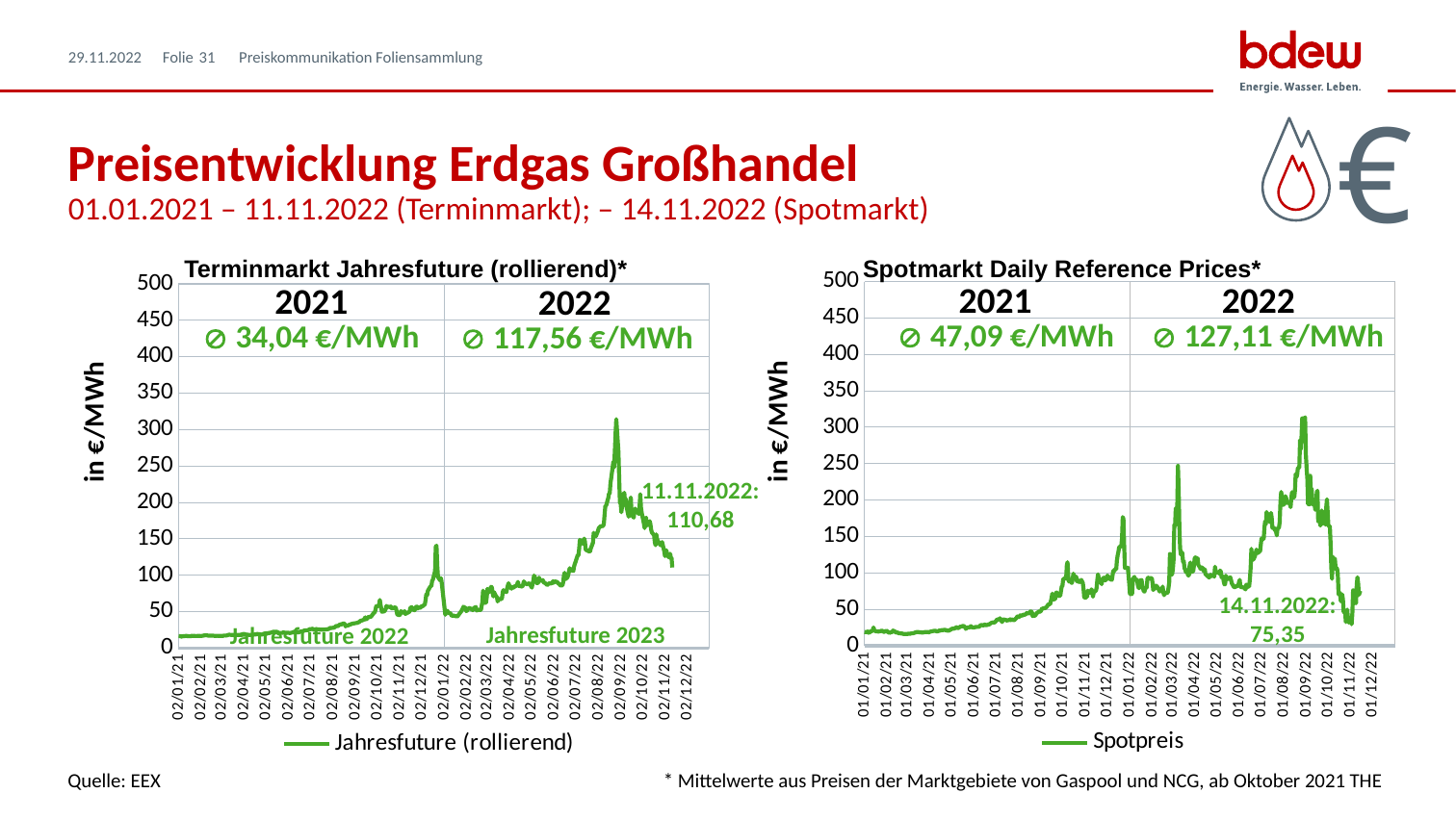
On the Terminmarkt Jahresfuture (rollierend) chart, what value is labelled for 11.11.2022? 110,68 On the Spotmarkt Daily Reference Prices chart, what is the average value shown for 2021? 47,09 €/MWh On the Spotmarkt Daily Reference Prices chart, what is the average value shown for 2022? 127,11 €/MWh On the Terminmarkt Jahresfuture (rollierend) chart, what is the difference between the 2022 average and the 2021 average? 83,52 €/MWh On the Spotmarkt Daily Reference Prices chart, what is the difference between the 2022 average and the 2021 average? 80,02 €/MWh Which chart shows the higher 2022 average, Terminmarkt Jahresfuture (rollierend) or Spotmarkt Daily Reference Prices? Spotmarkt Daily Reference Prices On the Terminmarkt Jahresfuture (rollierend) chart, what is the average value shown for 2021? 34,04 €/MWh On the Spotmarkt Daily Reference Prices chart, is the peak value in September 2022 greater or less than 250? greater On the Spotmarkt Daily Reference Prices chart, what value is labelled for 14.11.2022? 75,35 On the Terminmarkt Jahresfuture (rollierend) chart, what is the average value shown for 2022? 117,56 €/MWh What type of chart is the Spotmarkt Daily Reference Prices chart? Line chart What legend entry is shown below the Terminmarkt Jahresfuture (rollierend) chart? Jahresfuture (rollierend)